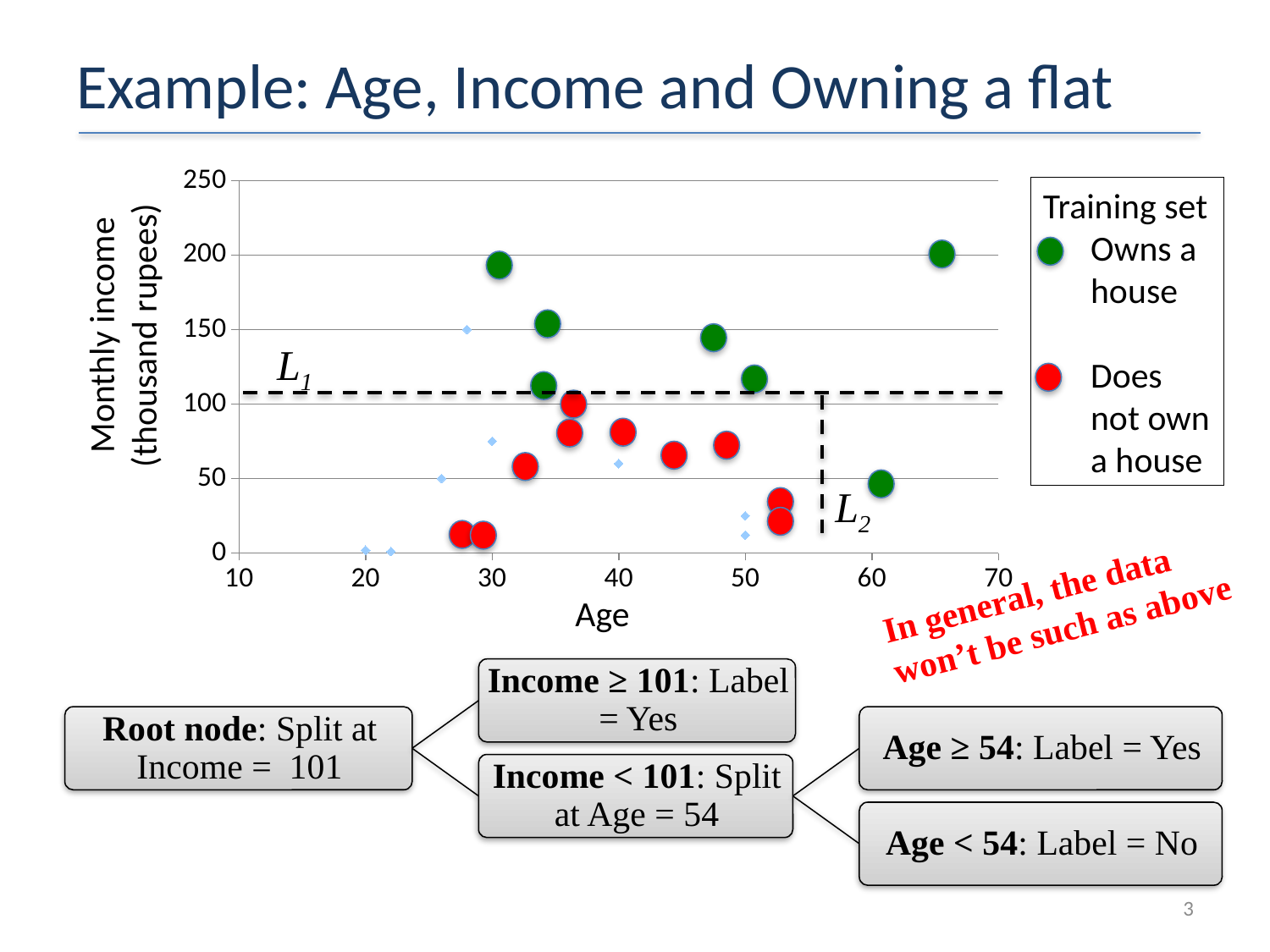
Is the monthly income of the green point at about age 60 greater or less than 100? less What is the title of the chart's legend? Training set How many green 'Owns a house' points are plotted? 7 What kind of chart is shown on the slide? Scatter plot Is the monthly income of the green point at about age 47 greater or less than 100? greater Is the monthly income of the green point at about age 65 greater or less than 150? greater Which has the higher monthly income: the green point at about age 65 or the red point at about age 44? The green point at about age 65 Which series has more plotted points: 'Owns a house' or 'Does not own a house'? Does not own a house How many series does the chart legend list? 2 How many red 'Does not own a house' points are plotted? 10 What is the label of the vertical axis? Monthly income (thousand rupees)